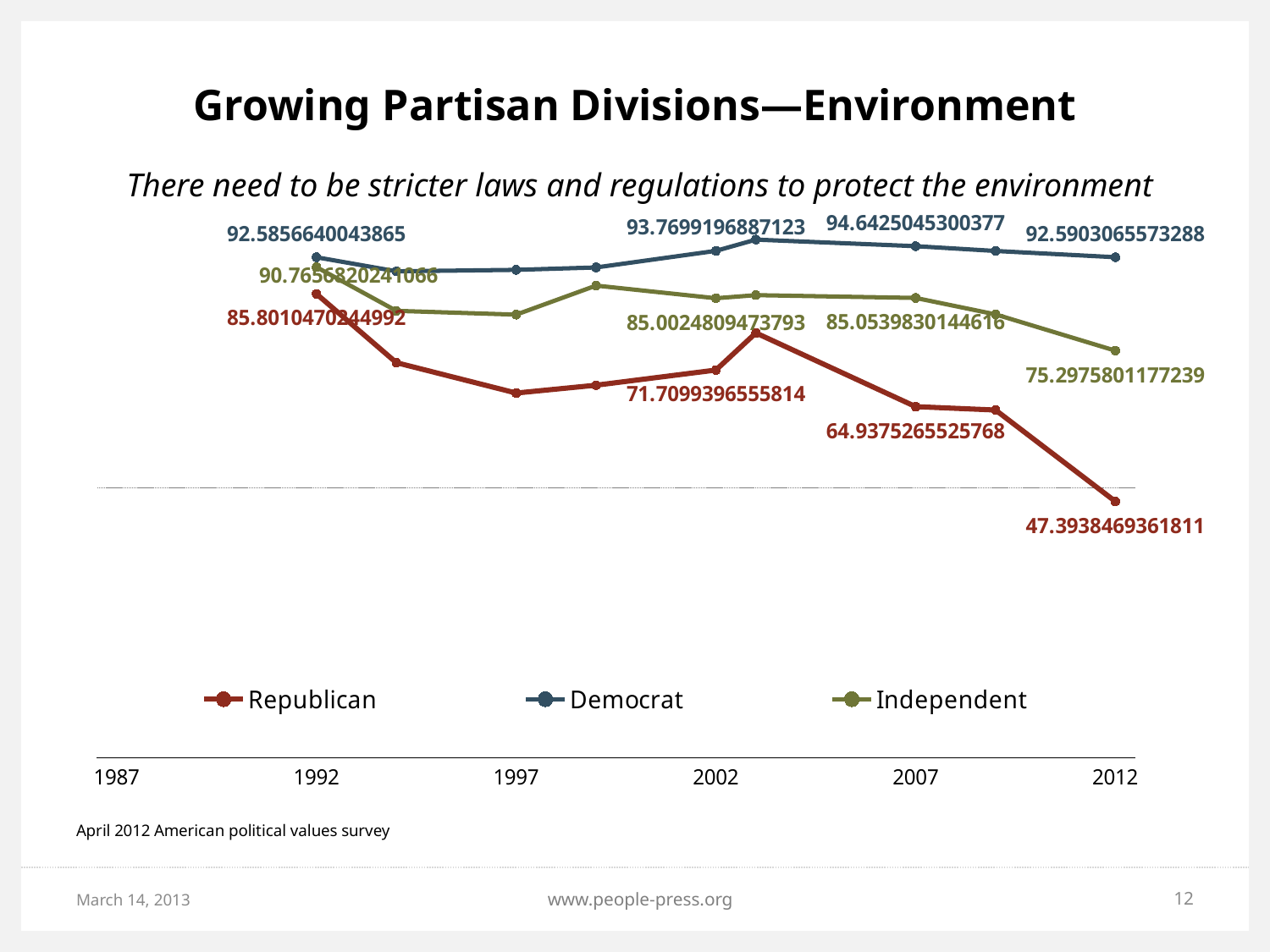
Which series has the highest value in 2007? Democrat Which series has the lowest value in 2012? Republican Which is larger in 2012, the Independent value or the Republican value? Independent What is the Republican value in 1992? 85.8010470244992 What is the Republican value in 2012? 47.3938469361811 What is the Democrat value in 2012? 92.5903065573288 What is the Independent value in 2007? 85.0539830144616 What is the difference between the Democrat and Republican values in 2012? 45.1964596211477 What is the Democrat value in 2007? 94.6425045300377 What kind of chart is shown on the slide? Line chart How many series does the legend list? 3 By how much did the Republican value fall from 1992 to 2012? 38.4072000883181